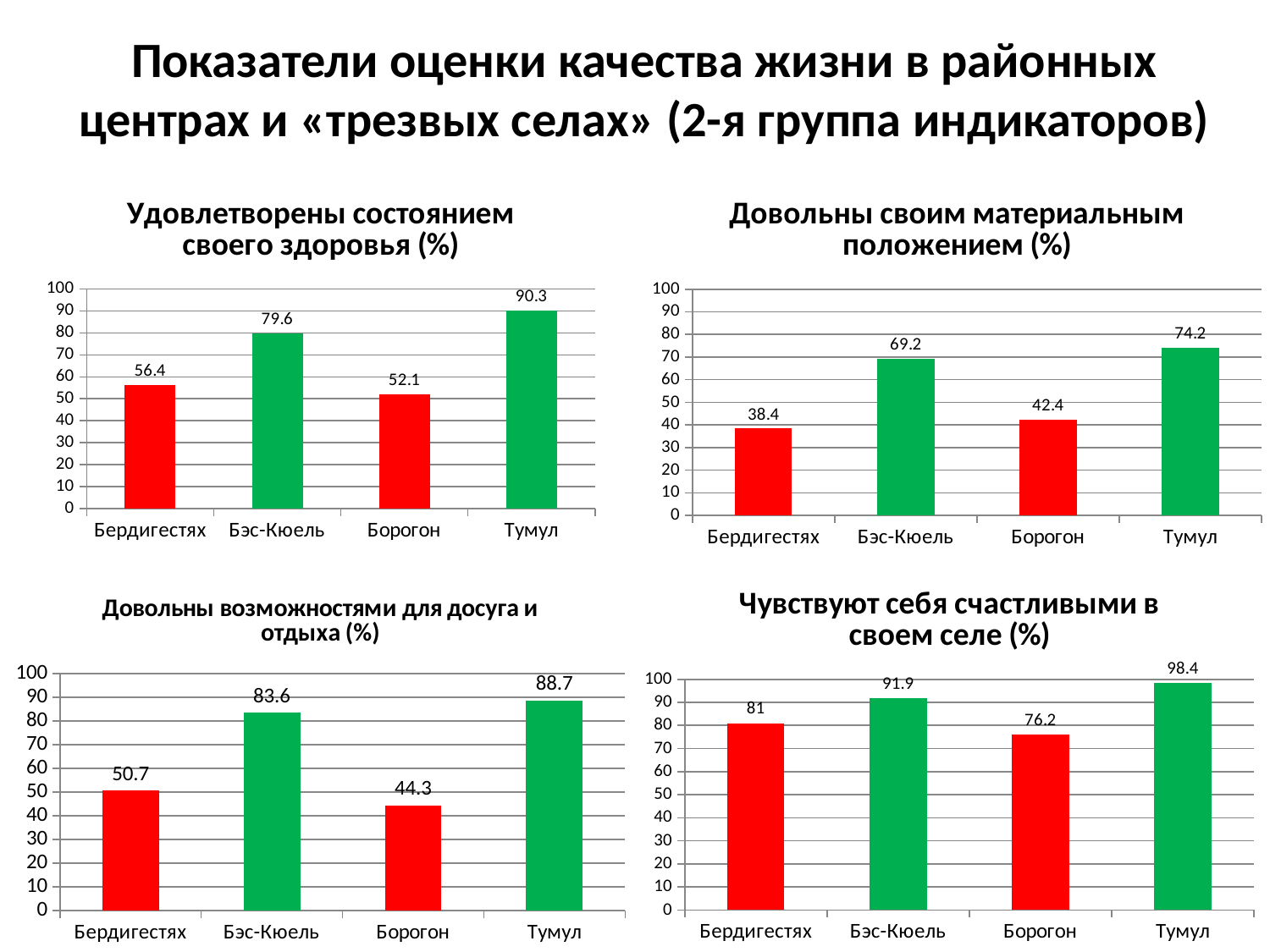
In the chart 'Довольны своим материальным положением (%)', which category has the highest value? Тумул In the chart 'Удовлетворены состоянием своего здоровья (%)', which category has the lowest value? Борогон In the chart 'Чувствуют себя счастливыми в своем селе (%)', what is the value for Тумул? 98.4 In the chart 'Довольны возможностями для досуга и отдыха (%)', which is larger, the value for Бердигестях or the value for Борогон? Бердигестях In the chart 'Довольны возможностями для досуга и отдыха (%)', what is the value for Борогон? 44.3 In the chart 'Чувствуют себя счастливыми в своем селе (%)', what is the difference between the values for Бэс-Кюель and Бердигестях? 10.9 In the chart 'Довольны своим материальным положением (%)', what is the difference between the values for Тумул and Бэс-Кюель? 5 In the chart 'Довольны своим материальным положением (%)', what is the value for Бердигестях? 38.4 What kind of chart is 'Удовлетворены состоянием своего здоровья (%)'? Bar chart In the chart 'Удовлетворены состоянием своего здоровья (%)', what is the value for Бэс-Кюель? 79.6 How many charts are shown on the slide? 4 How many categories are shown in the chart 'Чувствуют себя счастливыми в своем селе (%)'? 4